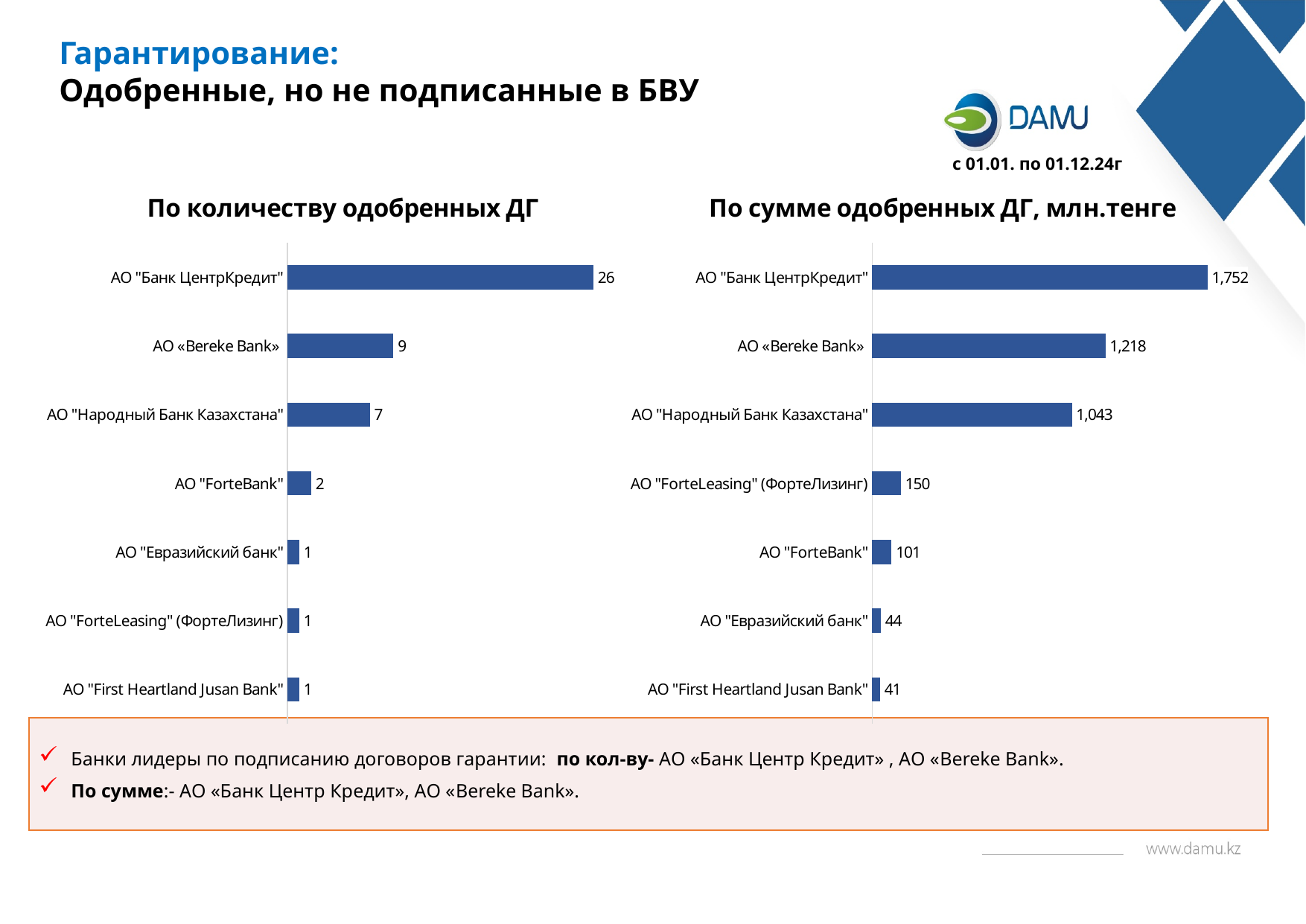
In the chart "По сумме одобренных ДГ, млн.тенге", which bank has the lowest value? АО "First Heartland Jusan Bank" What kind of chart is "По сумме одобренных ДГ, млн.тенге"? bar chart In the chart "По количеству одобренных ДГ", which bank has the highest value? АО "Банк ЦентрКредит" In the chart "По сумме одобренных ДГ, млн.тенге", what is the value for АО "ForteLeasing" (ФортеЛизинг)? 150 In the chart "По количеству одобренных ДГ", what is the value for АО "Банк ЦентрКредит"? 26 In the chart "По количеству одобренных ДГ", what is the value for АО "ForteBank"? 2 In the chart "По количеству одобренных ДГ", what is the difference between АО «Bereke Bank» and АО "Народный Банк Казахстана"? 2 In the chart "По сумме одобренных ДГ, млн.тенге", what is the difference between АО "Банк ЦентрКредит" and АО «Bereke Bank»? 534 How many banks are shown in the chart "По количеству одобренных ДГ"? 7 In the chart "По сумме одобренных ДГ, млн.тенге", which is larger: АО "ForteBank" or АО "Евразийский банк"? АО "ForteBank" In the chart "По сумме одобренных ДГ, млн.тенге", what is the value for АО «Bereke Bank»? 1,218 What period is stated on the slide for the data? с 01.01. по 01.12.24г